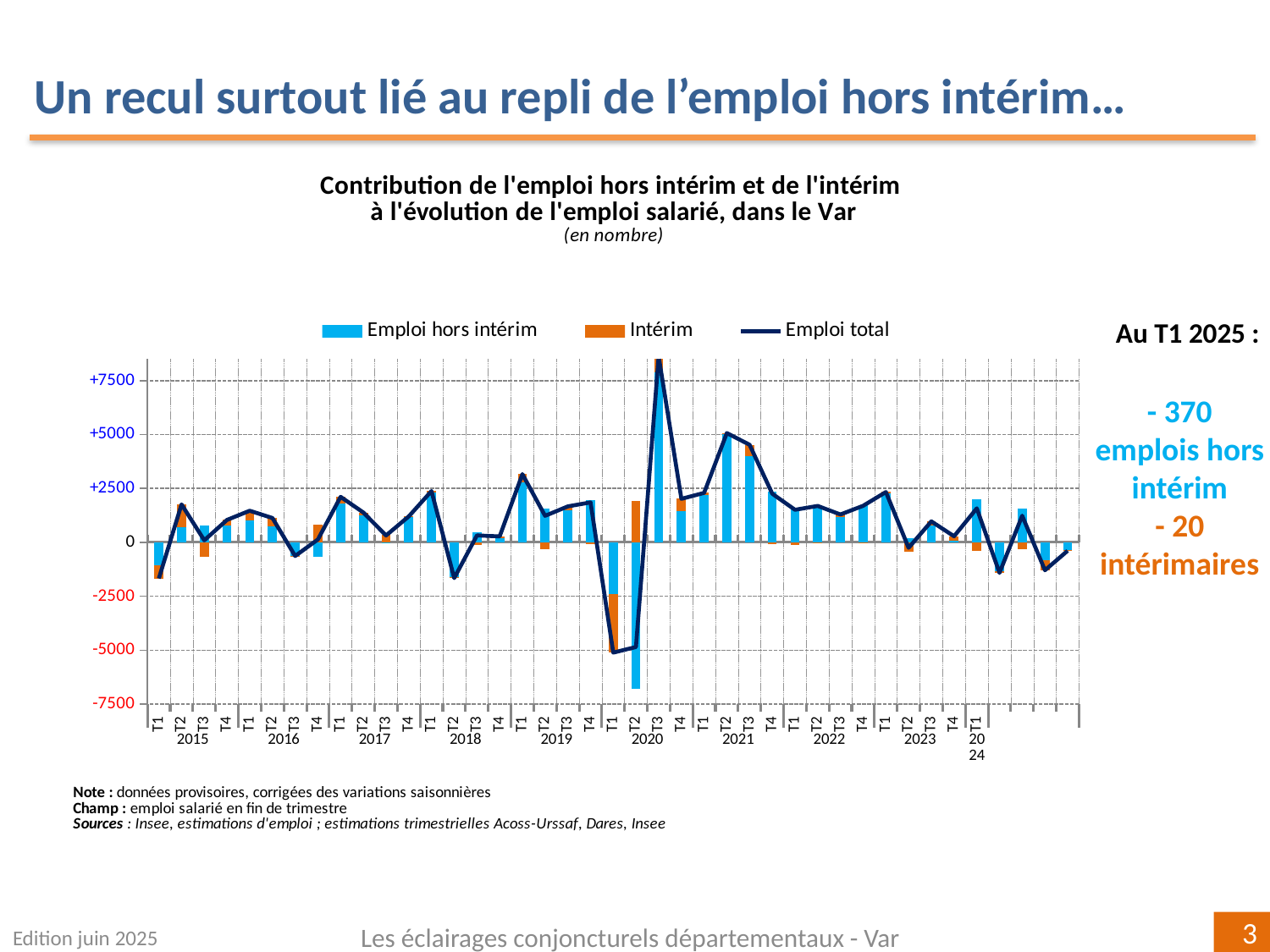
According to the annotation on the right of the chart, what is the change in intérimaires at T1 2025? - 20 Which series is drawn as a line rather than bars? Emploi total In which quarter does the Emploi total line reach its highest point? T3 2020 How many series does the chart legend list? 3 In which quarter is the Emploi hors intérim bar at its lowest? T2 2020 According to the annotation on the right of the chart, what is the change in emplois hors intérim at T1 2025? - 370 Is the Emploi total value at T3 2020 greater or less than +7500? greater Is the Emploi total value at T2 2021 greater or less than +2500? greater What kind of chart is shown on the slide? A combined bar and line chart Which is larger, the Emploi total value at T2 2021 or at T1 2019? T2 2021 Is the Emploi hors intérim value at T2 2020 greater or less than -5000? less Does the Emploi total line rise or fall from T2 2021 to T1 2022? It falls